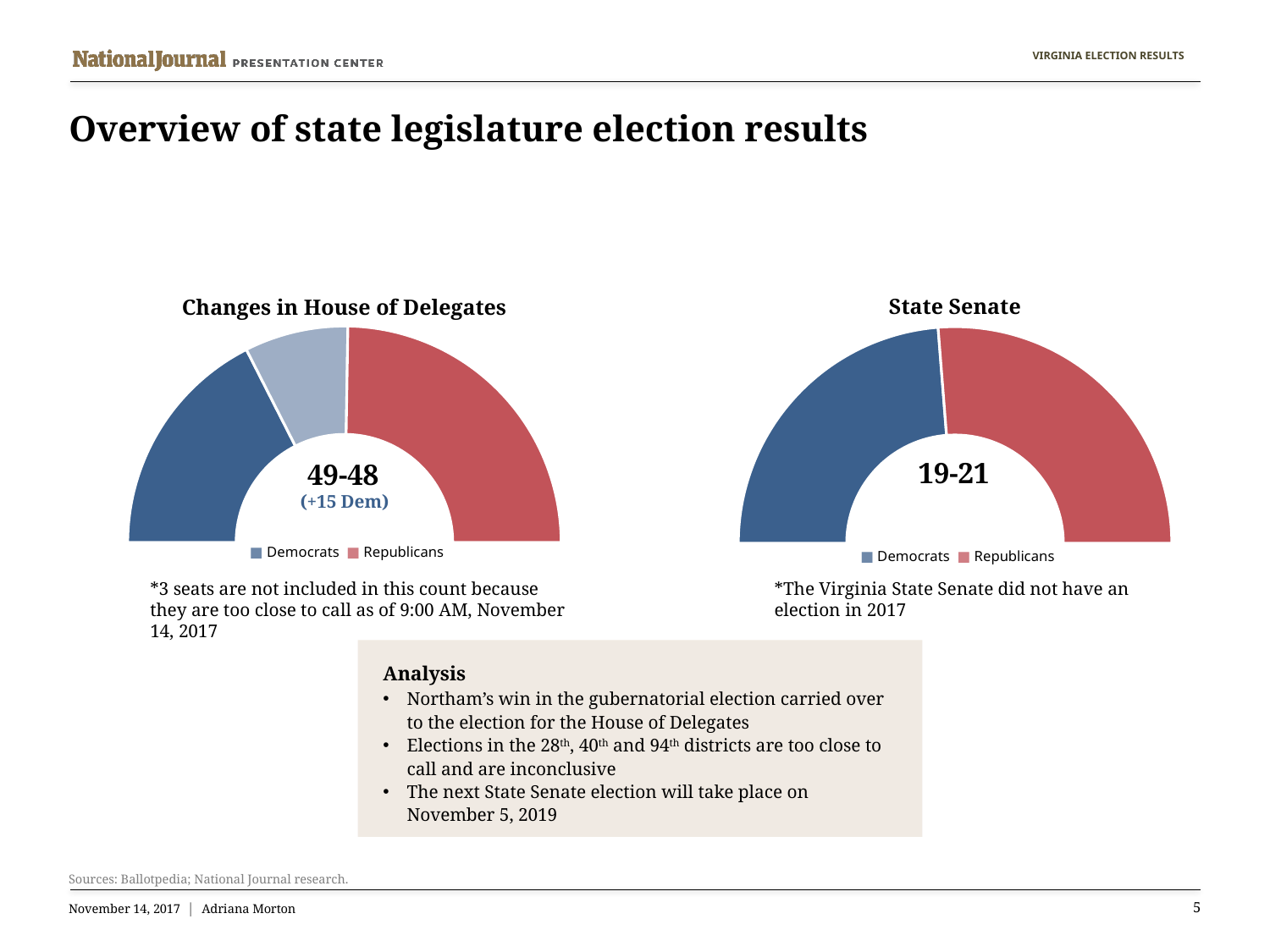
In the 'State Senate' chart, what seat count is printed in the center? 19-21 How many slices are drawn in the 'Changes in House of Delegates' chart? 3 In the 'State Senate' chart, which party has the larger slice, Democrats or Republicans? Republicans In the 'Changes in House of Delegates' chart, what change is noted below the seat count? +15 Dem In the 'Changes in House of Delegates' chart, what seat count is printed in the center? 49-48 How many series does the legend of the 'Changes in House of Delegates' chart list? 2 What kind of chart is the 'Changes in House of Delegates' chart? pie chart (half donut) How many series does the legend of the 'State Senate' chart list? 2 What kind of chart is the 'State Senate' chart? pie chart (half donut) What is the title of the chart on the left of the slide? Changes in House of Delegates In the 'State Senate' chart, what colour represents Democrats? blue How many slices are drawn in the 'State Senate' chart? 2